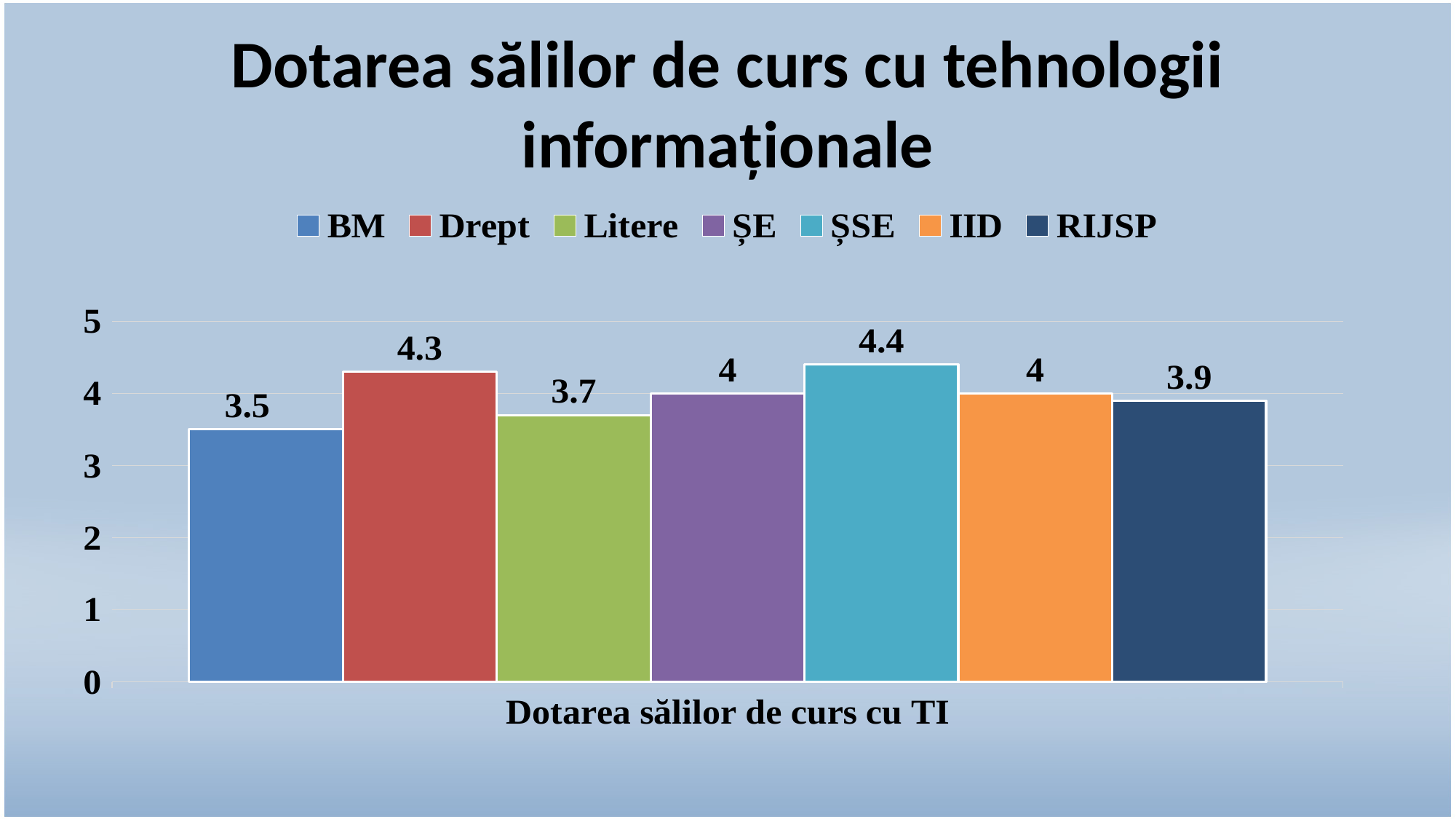
What is the title of the chart? Dotarea sălilor de curs cu tehnologii informaționale How many series does the legend list? 7 What is the value for Litere? 3.7 Is the value for IID greater or less than 3? greater What is the value for Drept? 4.3 What is the value for BM? 3.5 What is the difference between the values for ȘSE and BM? 0.9 Which series has the lowest value? BM What kind of chart is shown on the slide? bar chart What is the value for RIJSP? 3.9 Which series has the highest value? ȘSE Which is larger, the value for Drept or the value for Litere? Drept